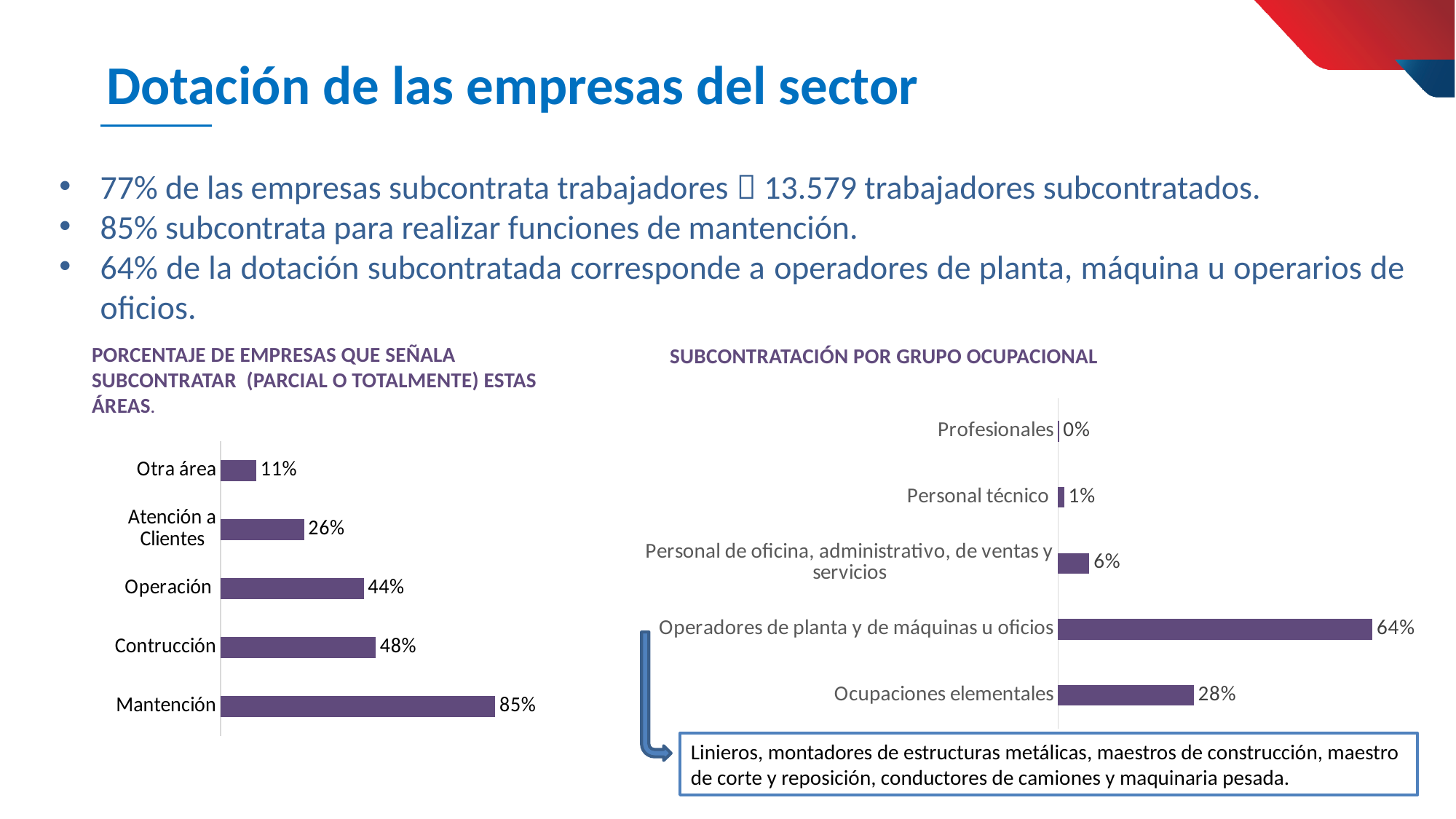
In the left chart (Porcentaje de empresas que señala subcontratar estas áreas), what is the difference between Contrucción and Operación? 4% In the left chart (Porcentaje de empresas que señala subcontratar estas áreas), how many categories are shown? 5 In the left chart (Porcentaje de empresas que señala subcontratar estas áreas), what is the value for Atención a Clientes? 26% In the left chart (Porcentaje de empresas que señala subcontratar estas áreas), which category has the lowest value? Otra área In the right chart (Subcontratación por grupo ocupacional), what is the value for Ocupaciones elementales? 28% In the left chart (Porcentaje de empresas que señala subcontratar estas áreas), what is the value for Mantención? 85% What type of chart is the right chart (Subcontratación por grupo ocupacional)? Bar chart In the right chart (Subcontratación por grupo ocupacional), which is larger: Personal de oficina, administrativo, de ventas y servicios or Personal técnico? Personal de oficina, administrativo, de ventas y servicios In the right chart (Subcontratación por grupo ocupacional), what is the value for Personal técnico? 1% In the right chart (Subcontratación por grupo ocupacional), which group has the lowest value? Profesionales In the right chart (Subcontratación por grupo ocupacional), what is the difference between Operadores de planta y de máquinas u oficios and Ocupaciones elementales? 36% In the right chart (Subcontratación por grupo ocupacional), which group has the highest value? Operadores de planta y de máquinas u oficios